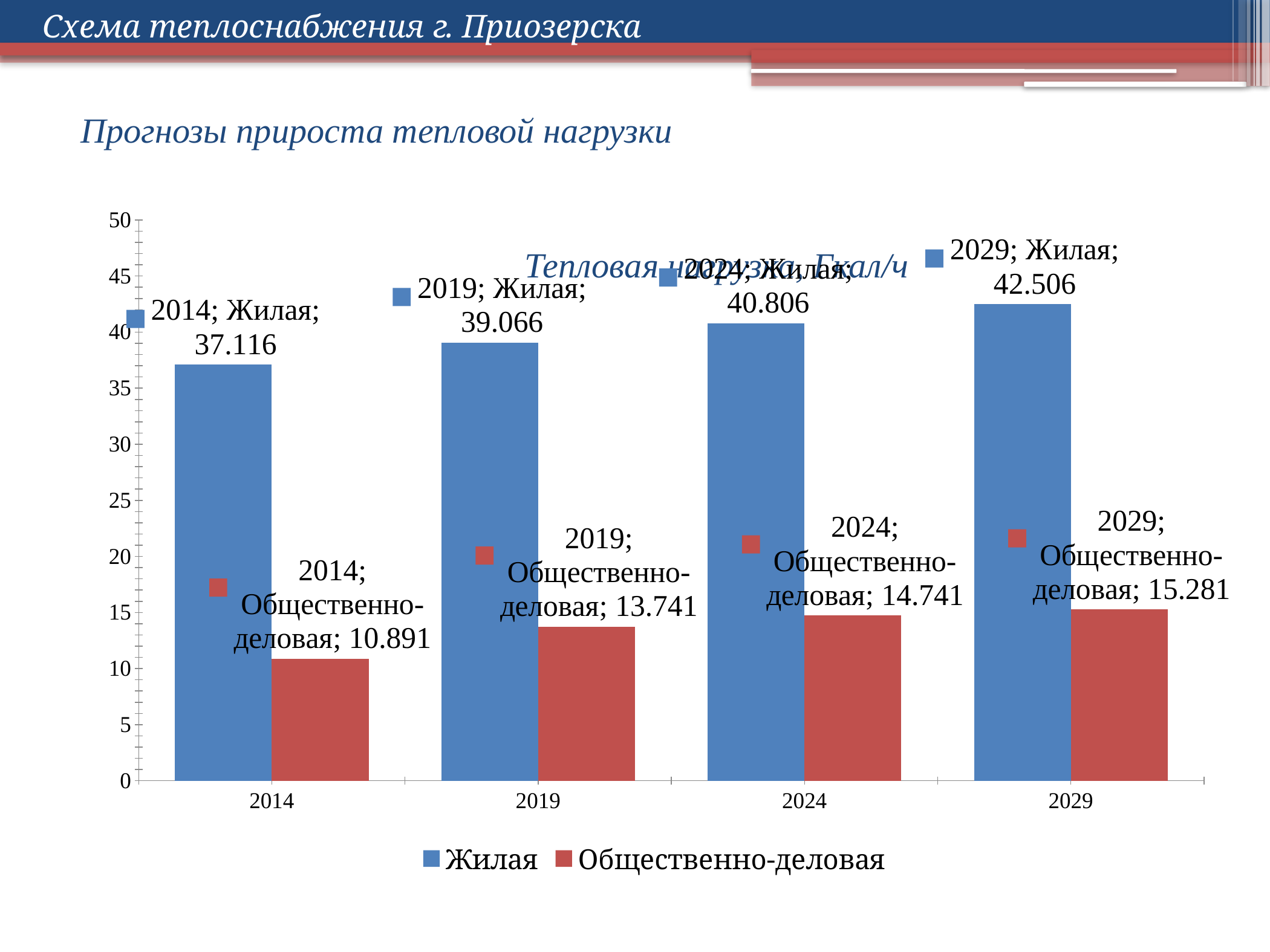
What is the value for Жилая in 2024? 40.806 What is the difference between the Жилая values for 2029 and 2014? 5.390 Do the Жилая values rise or fall from 2014 to 2029? Rise How many series does the legend list? 2 Which is larger: Общественно-деловая in 2024 or Общественно-деловая in 2019? Общественно-деловая in 2024 What is the value for Общественно-деловая in 2019? 13.741 What is the value for Жилая in 2014? 37.116 What kind of chart is shown on the slide? Bar chart In which year is the Жилая value highest? 2029 How many years are shown on the x axis? 4 What is the value for Общественно-деловая in 2029? 15.281 In which year is the Общественно-деловая value lowest? 2014